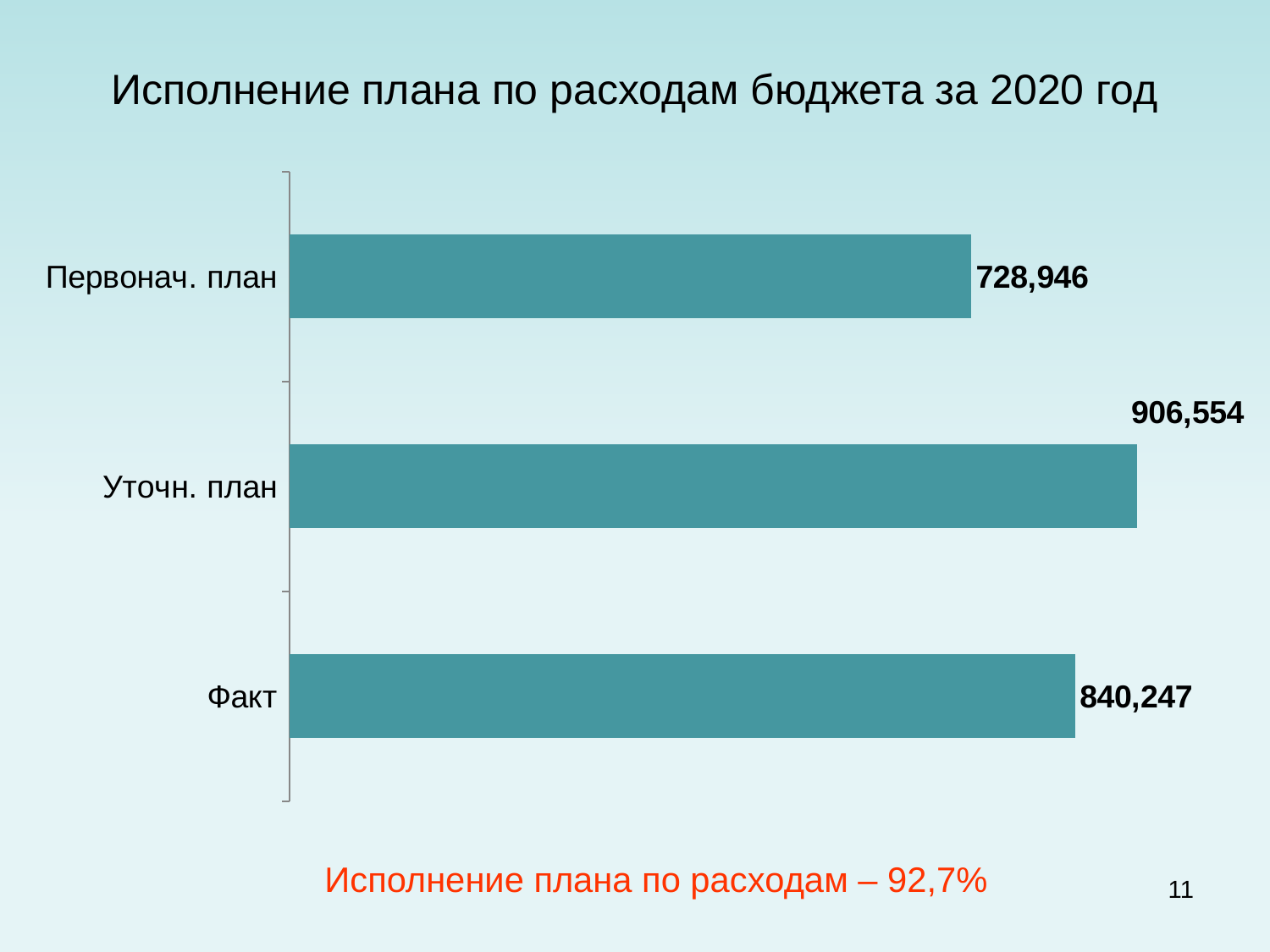
Which category has the lowest value? Первонач. план What is the difference between Уточн. план and Первонач. план? 177,608 What is the value for Первонач. план? 728,946 What type of chart is shown on the slide? Bar chart Which category has the highest value? Уточн. план What is the value for Факт? 840,247 What is the title of the slide? Исполнение плана по расходам бюджета за 2020 год Which is larger, Факт or Первонач. план? Факт What is the value for Уточн. план? 906,554 How many categories are shown in the chart? 3 What is the difference between Факт and Первонач. план? 111,301 What is the difference between Уточн. план and Факт? 66,307